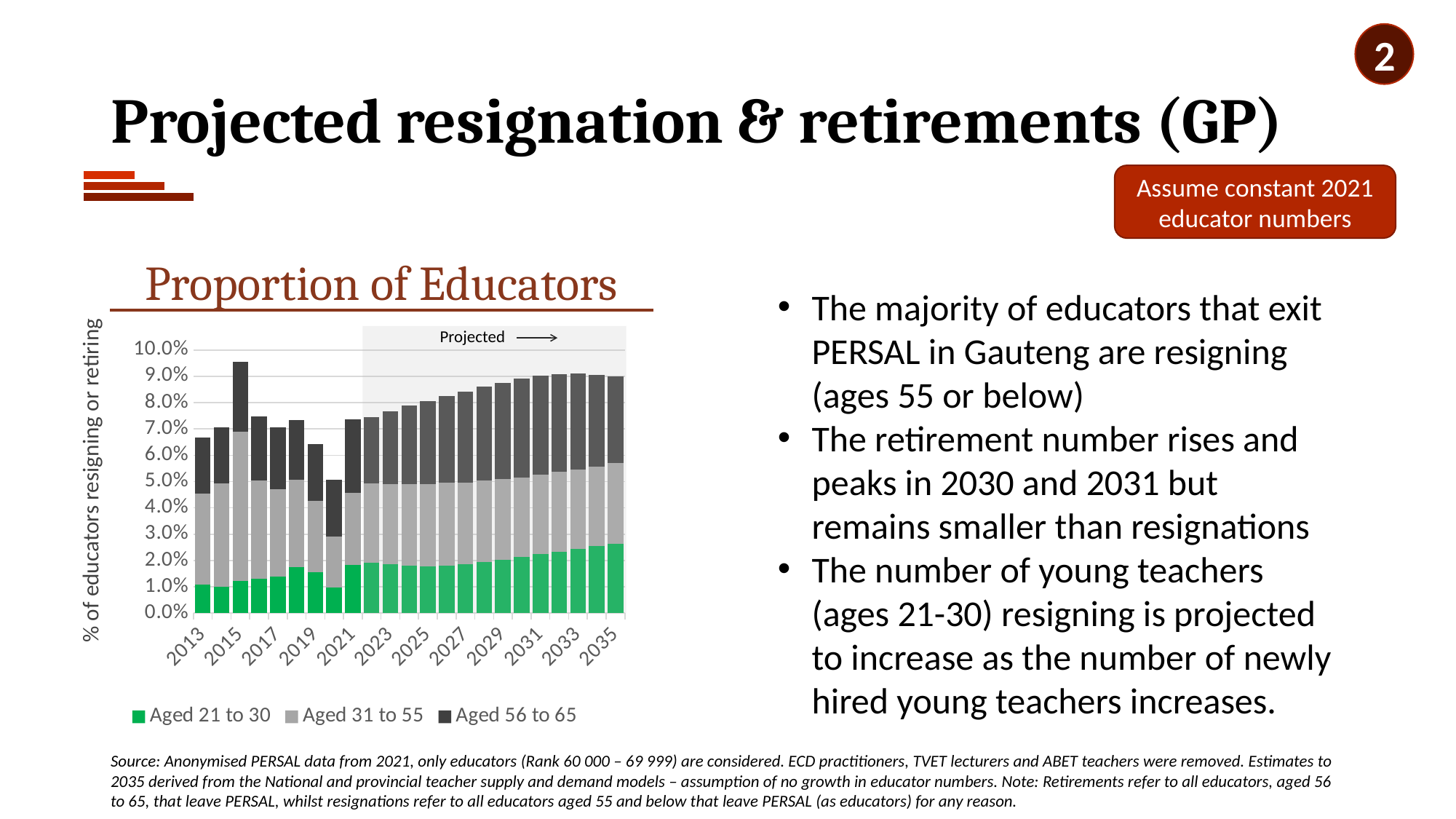
Which year has the lowest total proportion of educators resigning or retiring? 2020 Is the total value for 2013 greater or less than 7.0%? less Which year has a larger total proportion, 2020 or 2021? 2021 Which year has the highest total proportion of educators resigning or retiring? 2015 What is the title of the chart? Proportion of Educators Do the total bar heights rise or fall from 2021 to 2030? rise What are the three series listed in the chart legend? Aged 21 to 30, Aged 31 to 55, Aged 56 to 65 Is the total value for 2020 greater or less than 6.0%? less What kind of chart is shown on the slide? Stacked bar chart How many years (bars) are plotted in the chart? 23 How many series does the legend of the chart list? 3 Is the total value for 2015 greater or less than 9.0%? greater